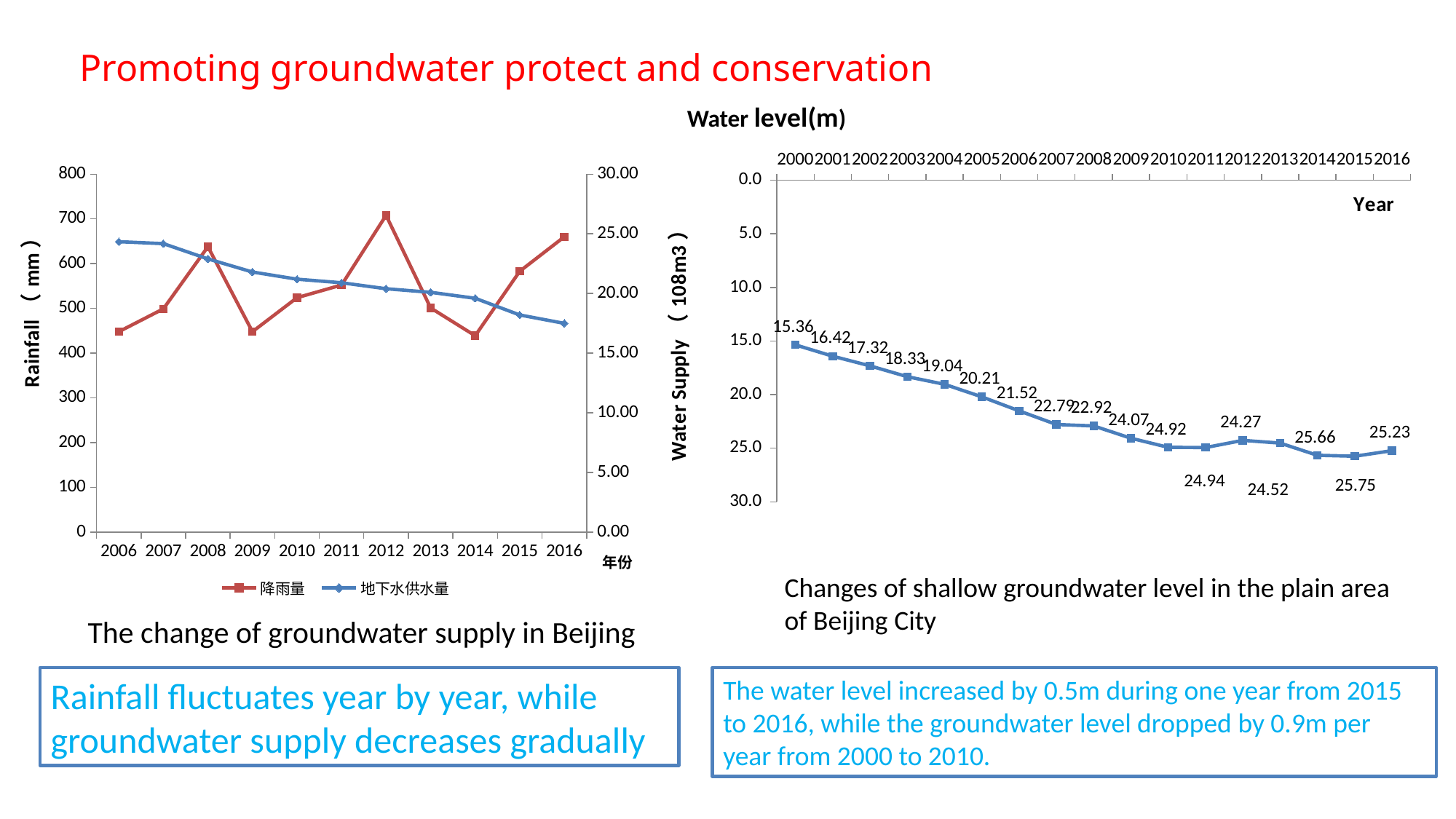
In the chart titled 'The change of groundwater supply in Beijing', which year has the highest rainfall (red line)? 2012 In the chart titled 'Changes of shallow groundwater level in the plain area of Beijing City', what is the water level value labelled for 2010? 24.92 In the chart titled 'The change of groundwater supply in Beijing', is the rainfall value for 2009 greater or less than 500? less In the chart titled 'Changes of shallow groundwater level in the plain area of Beijing City', what is the water level value labelled for 2016? 25.23 In the chart titled 'Changes of shallow groundwater level in the plain area of Beijing City', what is the water level value labelled for 2000? 15.36 In the chart titled 'Changes of shallow groundwater level in the plain area of Beijing City', which year has the largest labelled water level value? 2015 In the chart titled 'Changes of shallow groundwater level in the plain area of Beijing City', which year has the smallest labelled water level value? 2000 In the chart titled 'The change of groundwater supply in Beijing', how many series does the legend list? 2 In the chart titled 'Changes of shallow groundwater level in the plain area of Beijing City', what is the difference between the labelled values for 2015 and 2016? 0.52 In the chart titled 'Changes of shallow groundwater level in the plain area of Beijing City', is the labelled value for 2005 larger or smaller than the labelled value for 2012? smaller In the chart titled 'The change of groundwater supply in Beijing', does the groundwater supply (blue line) generally rise or fall from 2006 to 2016? fall In the chart titled 'Changes of shallow groundwater level in the plain area of Beijing City', how many years are plotted on the x axis? 17